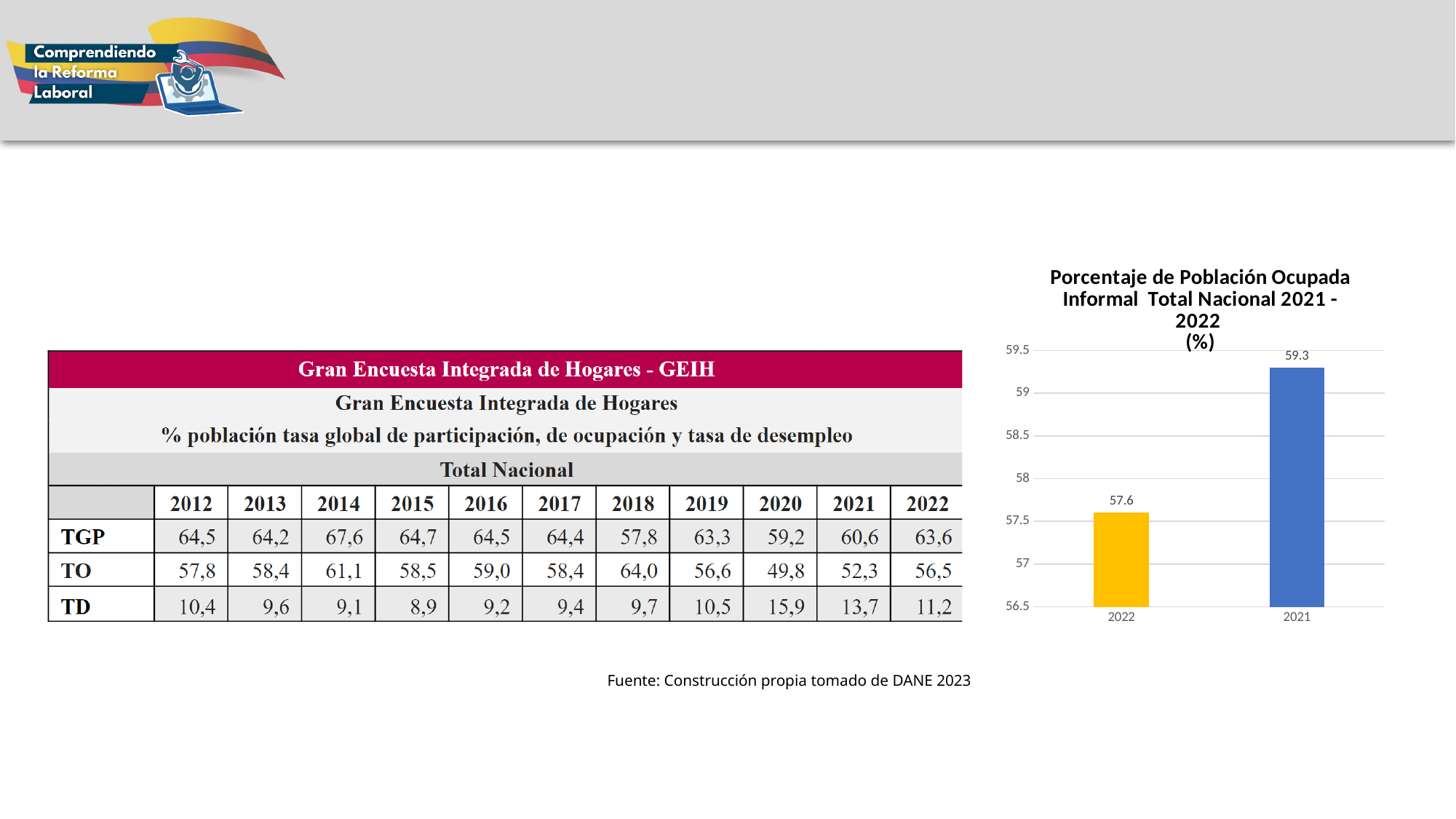
What colour is the bar for 2022 in the chart? yellow What is the value for 2022 in the chart? 57.6 What is the value for 2021 in the chart? 59.3 Which is larger in the chart, the value for 2022 or the value for 2021? 2021 Which category has the highest value in the chart? 2021 Is the value for 2022 greater or less than 58? less How many categories are shown in the chart? 2 What is the title of the chart? Porcentaje de Población Ocupada Informal Total Nacional 2021 - 2022 (%) Is the value for 2021 greater or less than 59? greater What is the difference between the values for 2021 and 2022 in the chart? 1.7 Which category has the lowest value in the chart? 2022 What kind of chart is shown on the slide? bar chart